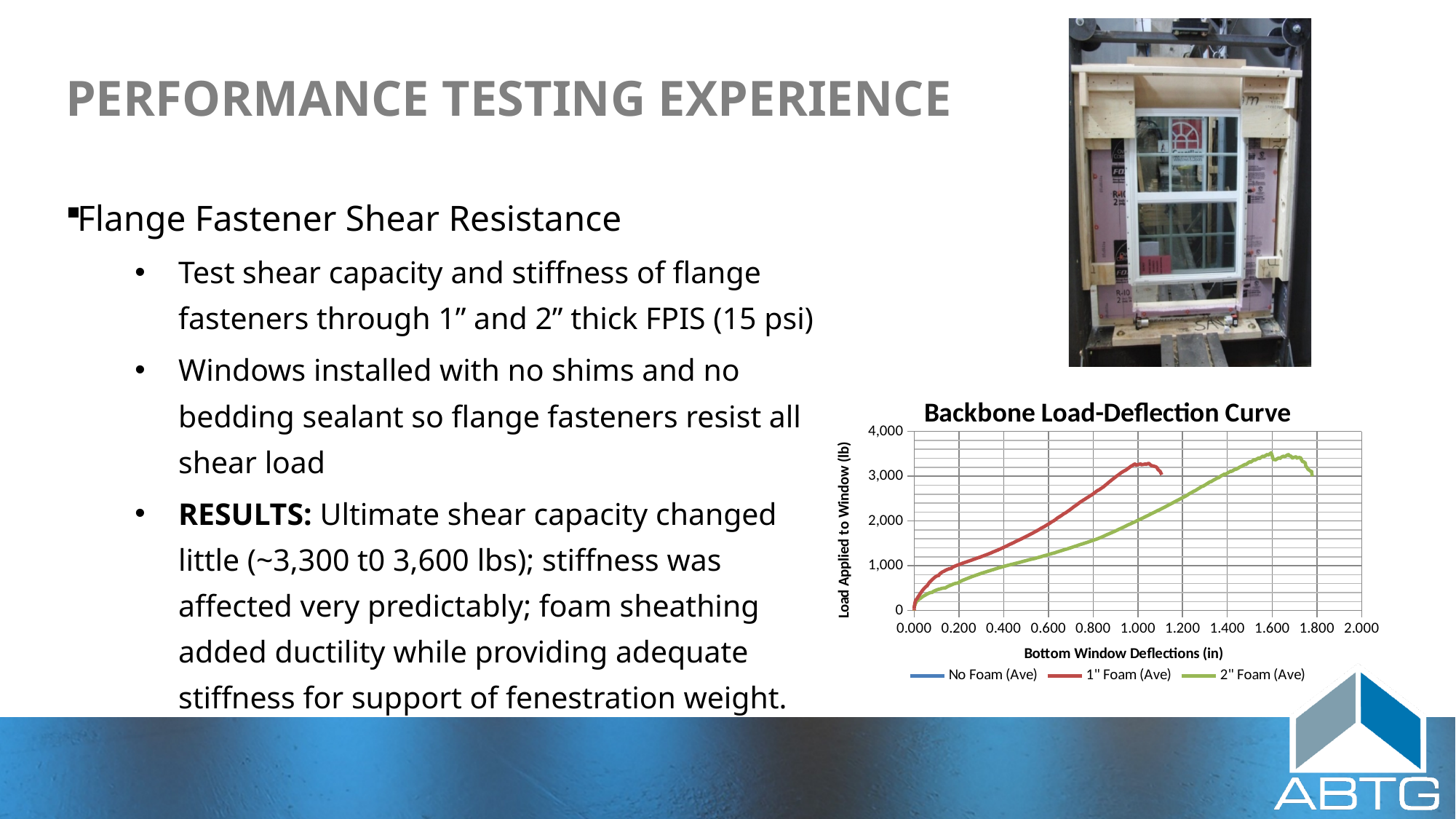
How many series does the legend of the Backbone Load-Deflection Curve list? 3 In the Backbone Load-Deflection Curve, at a deflection of 0.600 in, is the load for 1" Foam (Ave) greater or less than 1,000? greater In the Backbone Load-Deflection Curve, is the peak load for 1" Foam (Ave) greater or less than 3,000? greater In the Backbone Load-Deflection Curve, does the load for 2" Foam (Ave) generally rise or fall as deflection increases from 0.000 to 1.600 in? rise In the Backbone Load-Deflection Curve, at a deflection of 1.200 in, is the load for 2" Foam (Ave) greater or less than 2,000? greater What is the title of the chart on the slide? Backbone Load-Deflection Curve In the Backbone Load-Deflection Curve, which series extends to the larger bottom window deflection, 1" Foam (Ave) or 2" Foam (Ave)? 2" Foam (Ave) In the Backbone Load-Deflection Curve, which series reaches the higher peak load, 1" Foam (Ave) or 2" Foam (Ave)? 2" Foam (Ave) What is the label of the vertical axis of the Backbone Load-Deflection Curve? Load Applied to Window (lb) What kind of chart is the Backbone Load-Deflection Curve? line chart In the Backbone Load-Deflection Curve, at a deflection of 0.800 in, which series shows the higher load, 1" Foam (Ave) or 2" Foam (Ave)? 1" Foam (Ave)